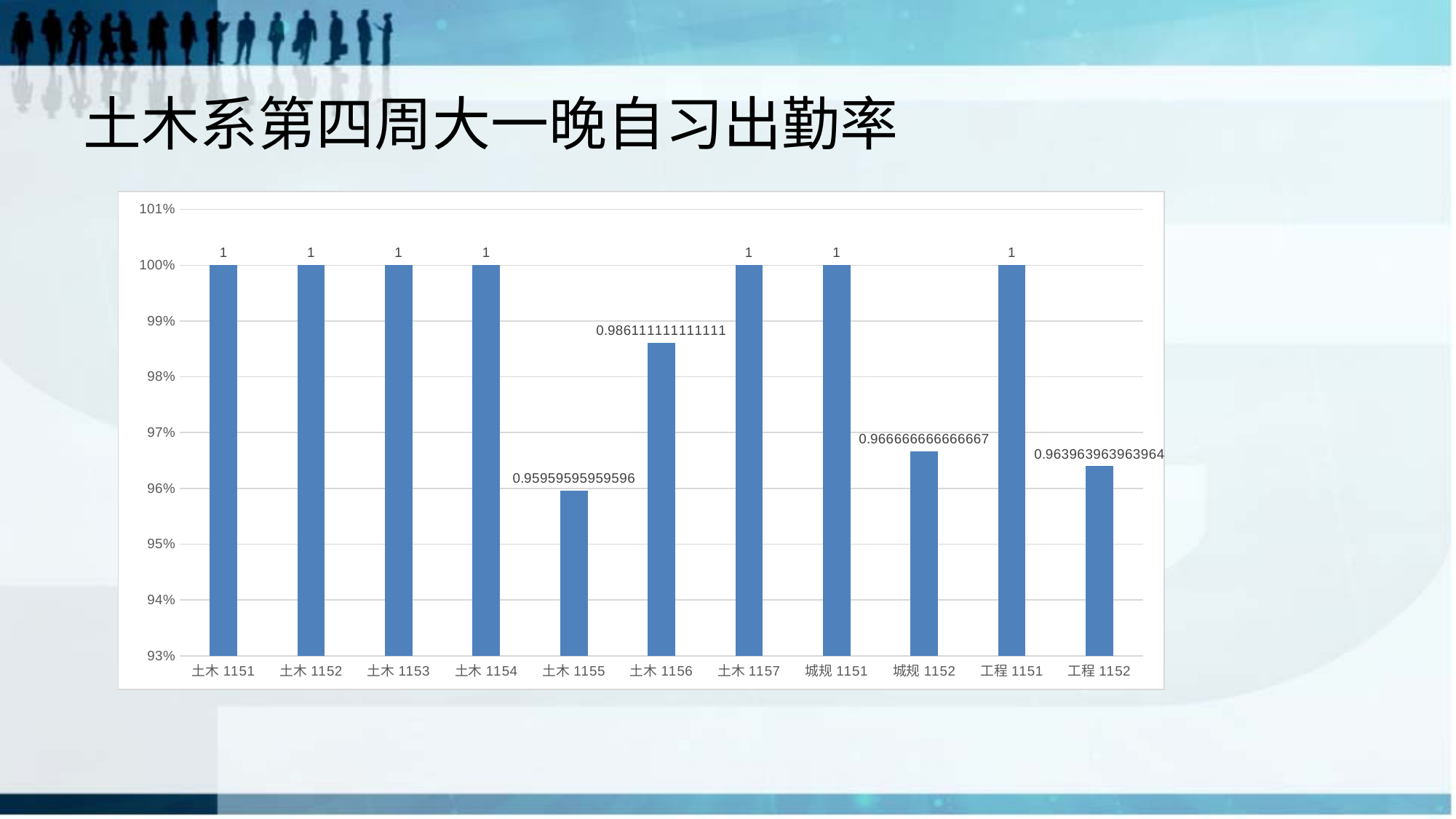
How many categories have a data label of 1? 7 Is the value for 土木 1156 greater or less than 98%? greater What is the data label shown for 土木 1155? 0.95959595959596 Which category has the lowest attendance rate? 土木 1155 Is the value for 工程 1152 greater or less than 97%? less What is the data label shown for 土木 1151? 1 What is the data label shown for 工程 1152? 0.963963963963964 What is the data label shown for 城规 1152? 0.966666666666667 What kind of chart is shown on the slide? bar chart Which is larger, the value for 土木 1156 or the value for 城规 1152? 土木 1156 What is the data label shown for 土木 1156? 0.986111111111111 How many categories are shown on the x axis? 11